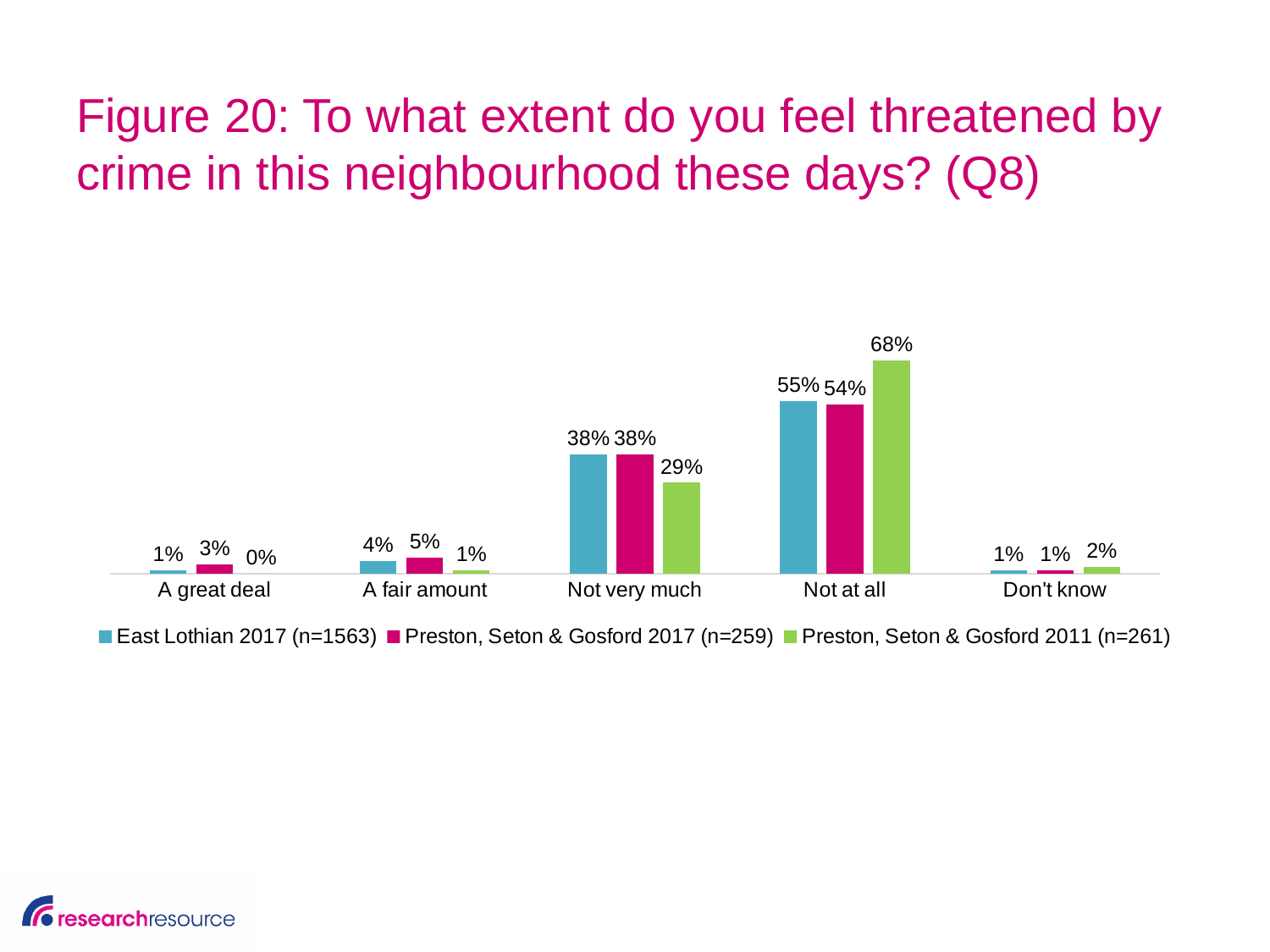
How many series does the legend list? 3 Which category has the highest value for Preston, Seton & Gosford 2011 (n=261)? Not at all What is the difference between the Preston, Seton & Gosford 2011 (n=261) and East Lothian 2017 (n=1563) values in the 'Not at all' category? 13% What kind of chart is shown on the slide? Bar chart How many categories are shown on the x axis? 5 Which colour represents Preston, Seton & Gosford 2011 (n=261) in the chart? Green What is the value for Preston, Seton & Gosford 2017 (n=259) in the 'A fair amount' category? 5% What is the value for Preston, Seton & Gosford 2011 (n=261) in the 'Not very much' category? 29% In the 'A great deal' category, which series has the larger value: East Lothian 2017 (n=1563) or Preston, Seton & Gosford 2017 (n=259)? Preston, Seton & Gosford 2017 (n=259) What is the difference between the Preston, Seton & Gosford 2017 (n=259) and Preston, Seton & Gosford 2011 (n=261) values in the 'Not very much' category? 9% Which category has the lowest value for Preston, Seton & Gosford 2011 (n=261)? A great deal What is the value for East Lothian 2017 (n=1563) in the 'Not at all' category? 55%